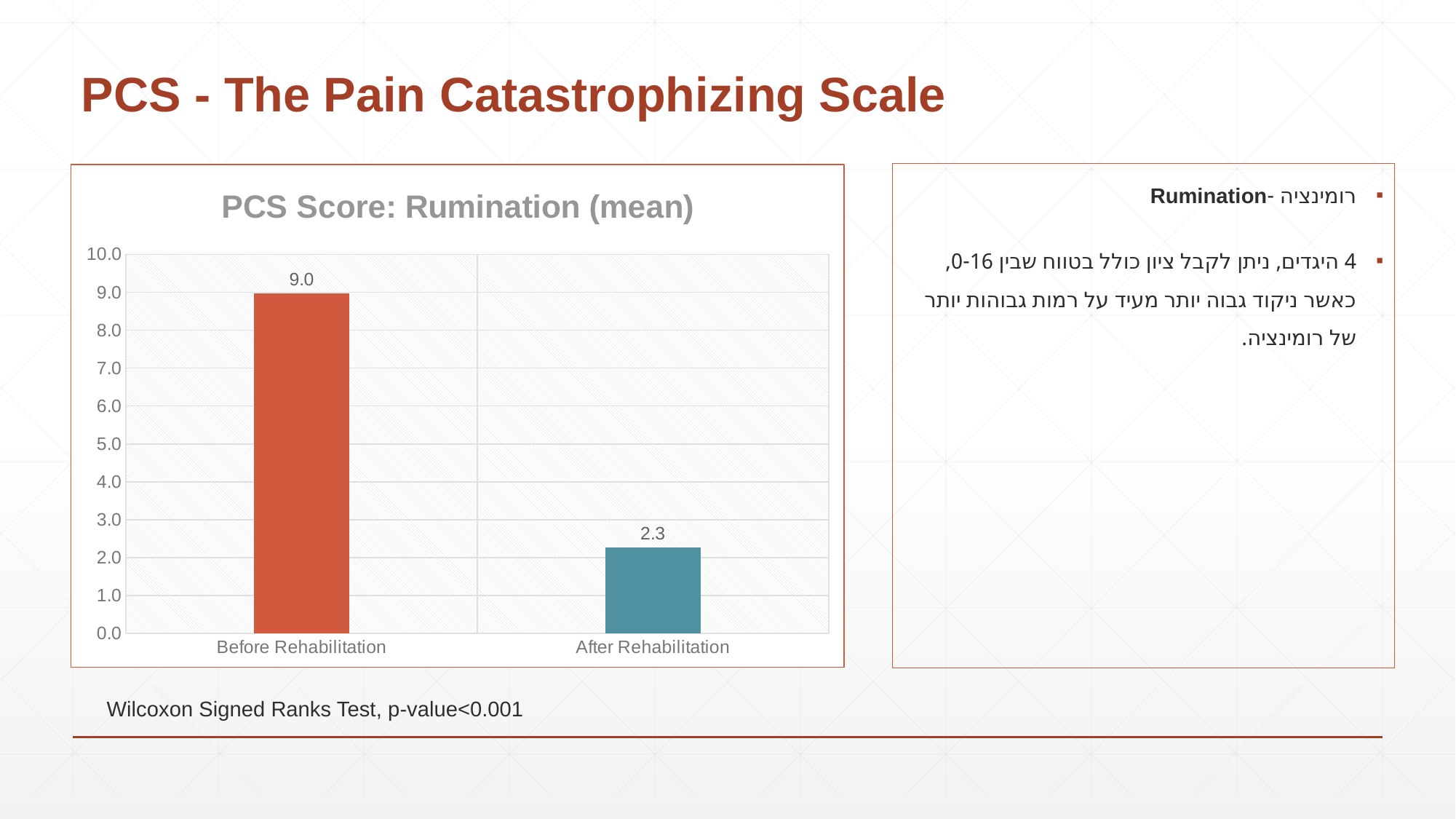
What is the title of the chart? PCS Score: Rumination (mean) What is the value for After Rehabilitation? 2.3 What is the difference between the Before Rehabilitation and After Rehabilitation values? 6.7 How many categories are shown on the x axis? 2 Which category has the highest value? Before Rehabilitation What is the value for Before Rehabilitation? 9.0 Is the value for After Rehabilitation greater or less than 3.0? less What kind of chart is shown? bar chart Is the value for Before Rehabilitation greater or less than 8.0? greater Do the values rise or fall from Before Rehabilitation to After Rehabilitation? fall Which is larger, the value for Before Rehabilitation or After Rehabilitation? Before Rehabilitation Which category has the lowest value? After Rehabilitation